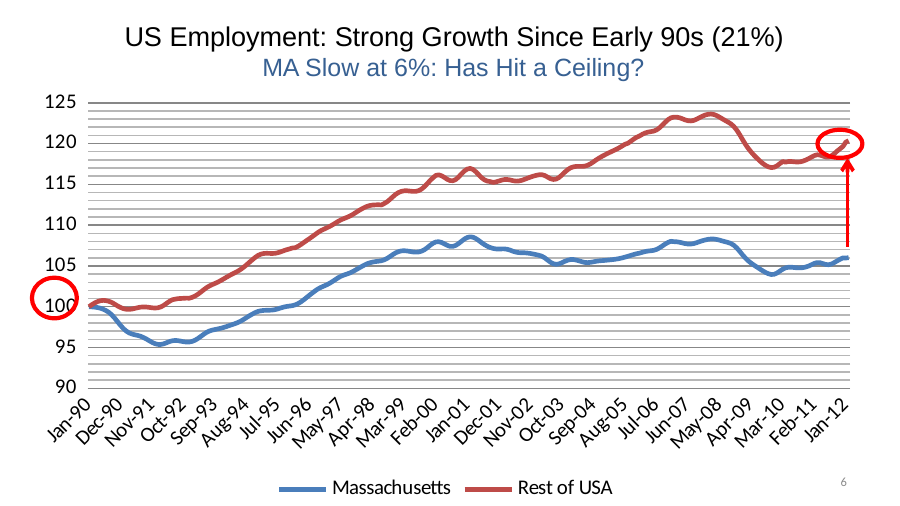
What kind of chart is shown on the slide? line chart Is the value for Massachusetts at Jan-12 greater or less than 100? greater Is the value for Massachusetts at Oct-92 greater or less than 100? less At Jan-12, which series has the higher value, Massachusetts or Rest of USA? Rest of USA What is the value of the Massachusetts series at Jan-90? 100 Which colour is used for the Massachusetts series? blue Is the value for Rest of USA at Jan-01 greater or less than 115? greater How many series does the legend list? 2 Does the Rest of USA series generally rise or fall from Jan-90 to Jan-12? rise What is the value of the Rest of USA series at Jan-90? 100 How many labels are shown on the x axis? 25